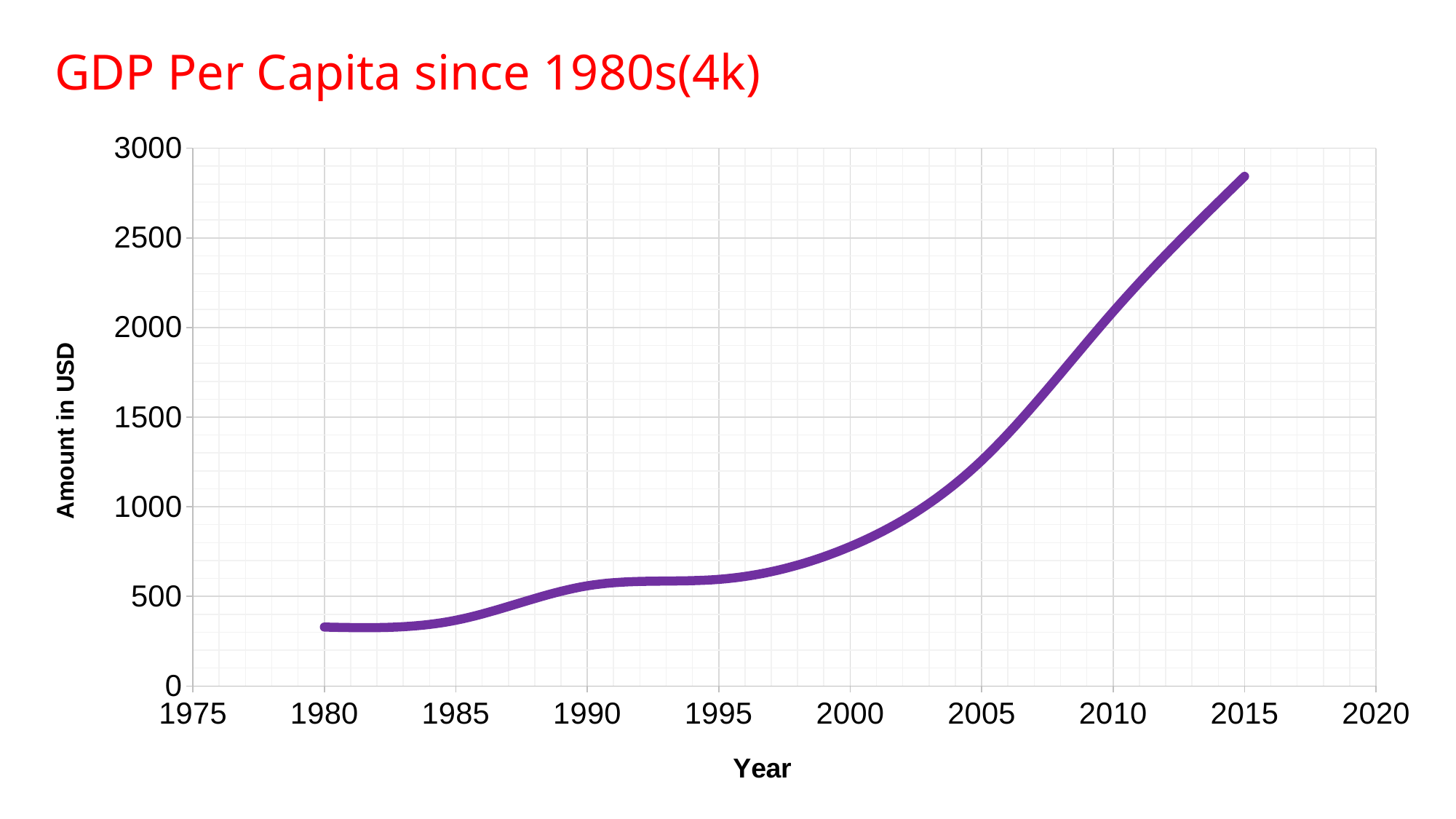
Is the value for 1980 greater or less than 500? less Do the values generally rise or fall from 1980 to 2015? rise Is the value for 1990 greater or less than 1000? less What is the title of the chart? GDP Per Capita since 1980s(4k) Is the value for 2000 greater or less than 1000? less Which year has the highest value on the chart? 2015 What is the label of the y axis? Amount in USD Which is larger, the value for 2005 or the value for 1995? 2005 Which year has the lowest value on the chart? 1980 What kind of chart is shown on the slide? line chart